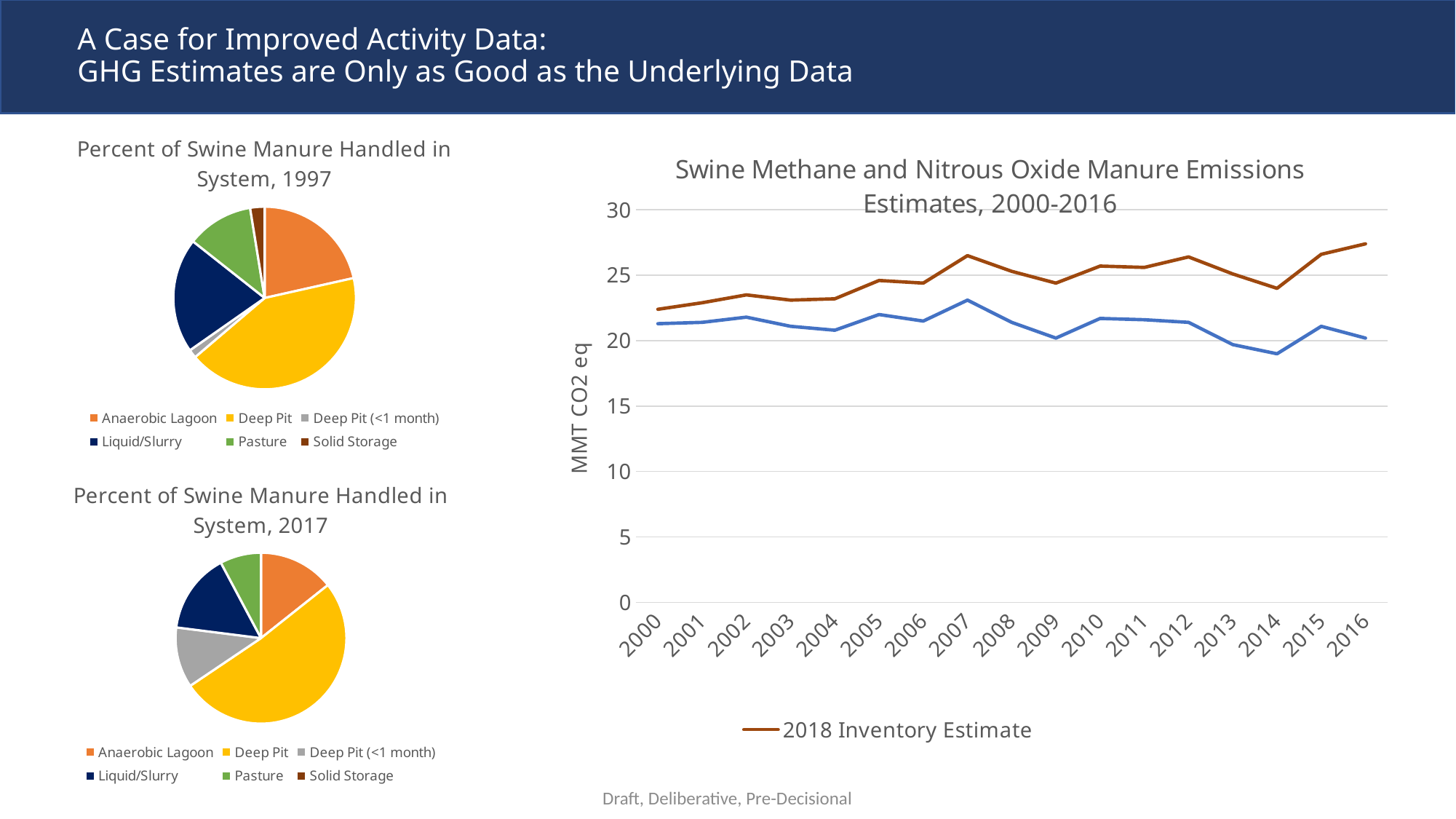
What kind of chart is "Percent of Swine Manure Handled in System, 1997"? Pie chart In the "Percent of Swine Manure Handled in System, 2017" chart, which slice is larger, Anaerobic Lagoon or Pasture? Anaerobic Lagoon In the "Swine Methane and Nitrous Oxide Manure Emissions Estimates, 2000-2016" chart, in which year is the 2018 Inventory Estimate highest? 2016 In the "Percent of Swine Manure Handled in System, 2017" chart, which system has the largest slice? Deep Pit What is the y-axis label of the "Swine Methane and Nitrous Oxide Manure Emissions Estimates, 2000-2016" chart? MMT CO2 eq How many systems are listed in the legend of the "Percent of Swine Manure Handled in System, 1997" chart? 6 In the "Swine Methane and Nitrous Oxide Manure Emissions Estimates, 2000-2016" chart, is the 2018 Inventory Estimate value for 2016 greater or less than 25? greater In the "Percent of Swine Manure Handled in System, 1997" chart, which system has the largest slice? Deep Pit In the "Percent of Swine Manure Handled in System, 1997" chart, which slice is larger, Liquid/Slurry or Pasture? Liquid/Slurry What kind of chart is "Swine Methane and Nitrous Oxide Manure Emissions Estimates, 2000-2016"? Line chart In the "Swine Methane and Nitrous Oxide Manure Emissions Estimates, 2000-2016" chart, how many years are shown on the x axis? 17 In the "Swine Methane and Nitrous Oxide Manure Emissions Estimates, 2000-2016" chart, is the 2018 Inventory Estimate value for 2000 greater or less than 25? less